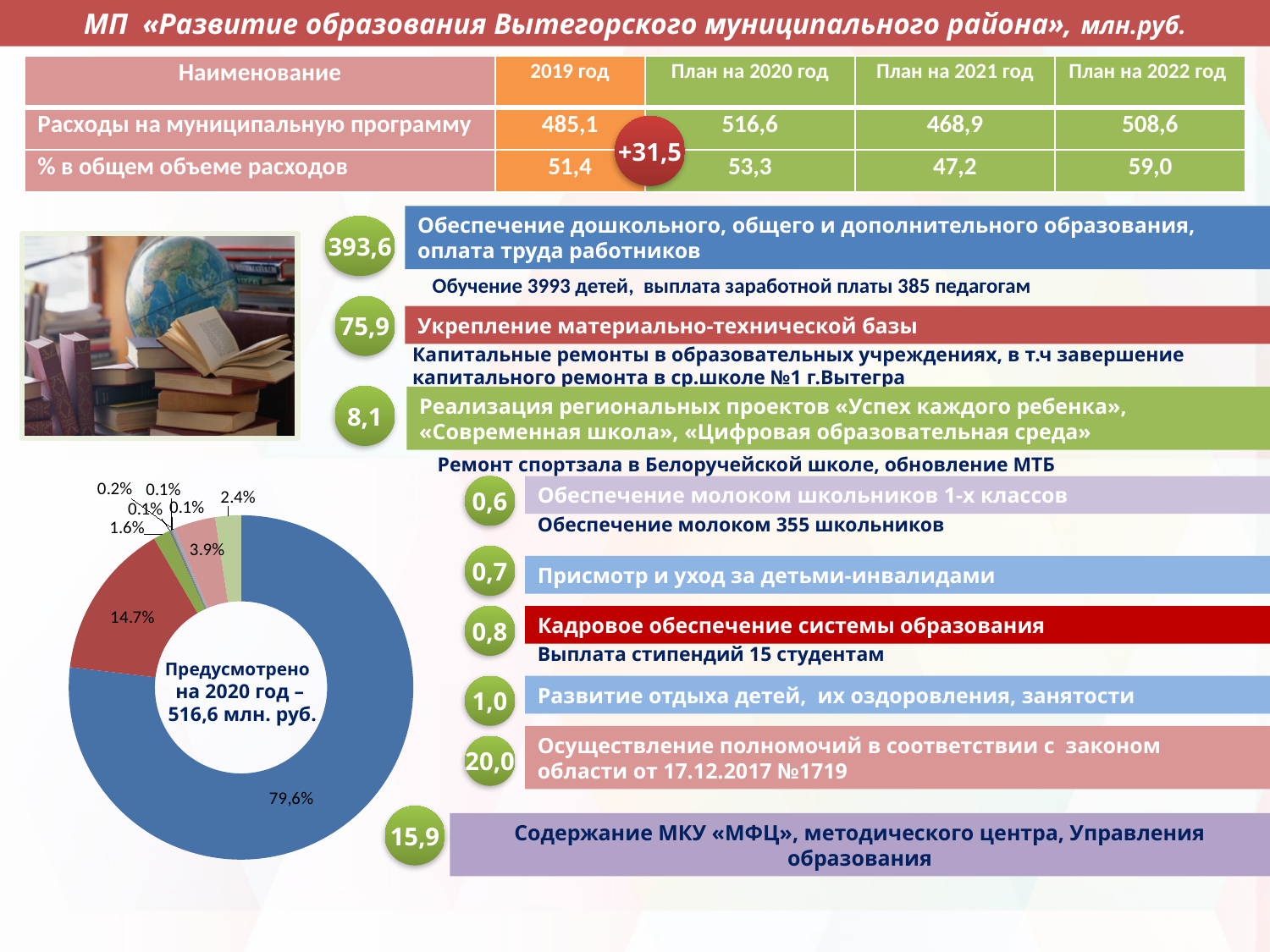
Which year does the centre text of the doughnut chart refer to? 2020 How many slices are labelled on the doughnut chart? 9 Is the largest slice of the doughnut chart greater or less than 50%? greater Which is larger in the doughnut chart: the slice labelled 3.9% or the slice labelled 2.4%? 3.9% Is the slice labelled 14.7% greater or less than 10%? greater How many slices in the doughnut chart are labelled 0.1%? 3 What kind of chart is shown on the slide? Doughnut (pie) chart What is the difference between the 3.9% slice and the 1.6% slice in the doughnut chart? 2.3% What is the smallest share labelled on the doughnut chart? 0.1% What is the share of the second-largest slice in the doughnut chart? 14.7% What total amount is stated in the centre of the doughnut chart? 516,6 млн. руб. What is the share of the largest slice in the doughnut chart? 79,6%